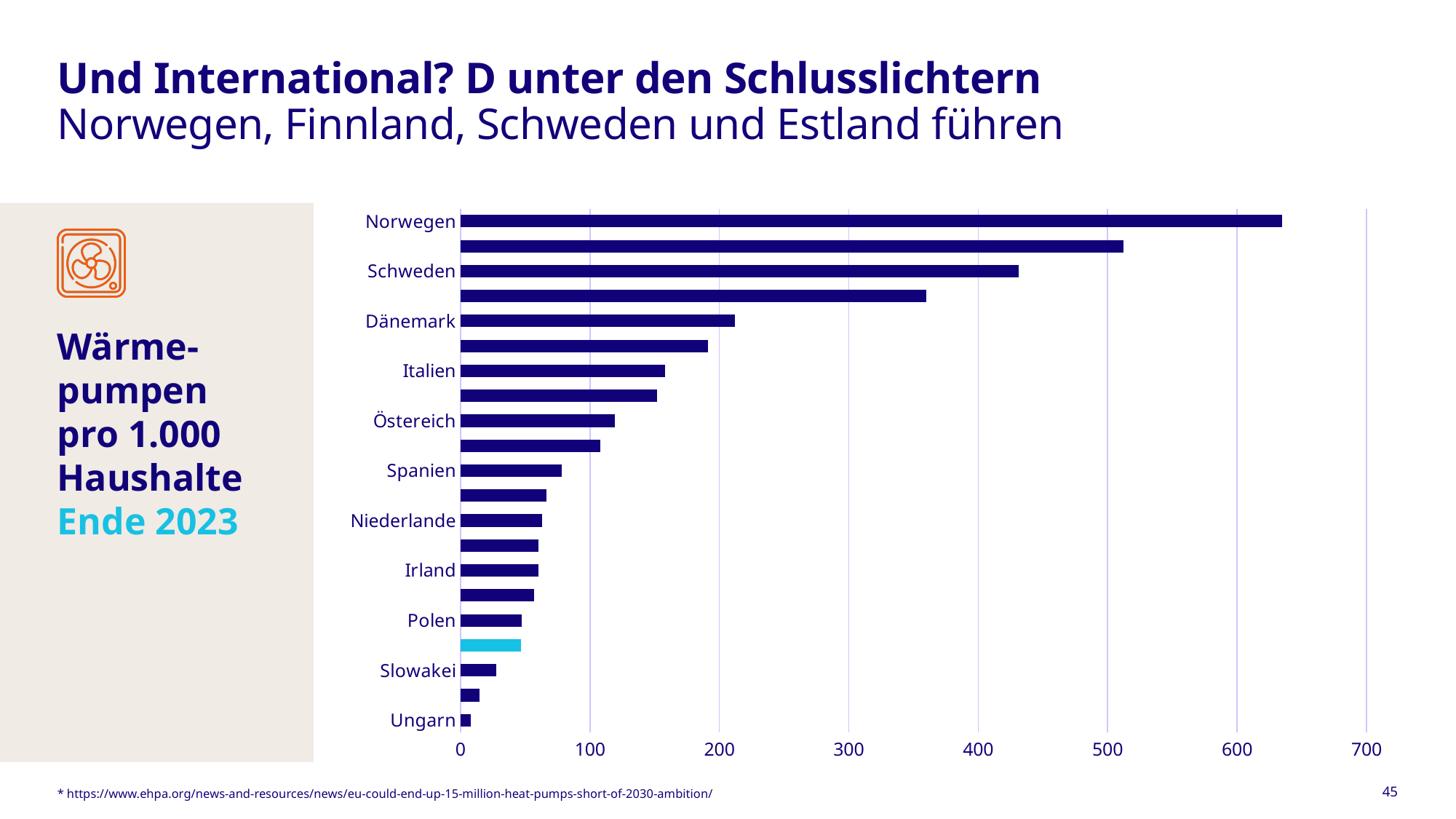
Is the value for Italien greater or less than 100? greater Which has the larger value, Schweden or Dänemark? Schweden Is the value for Norwegen greater or less than 600? greater Is the value for Dänemark greater or less than 200? greater Which country has the highest value in the chart? Norwegen Which has the larger value, Italien or Spanien? Italien Do the bar values increase or decrease from the top of the chart to the bottom? Decrease What kind of chart is shown on the slide? Bar chart Which country has the lowest value in the chart? Ungarn